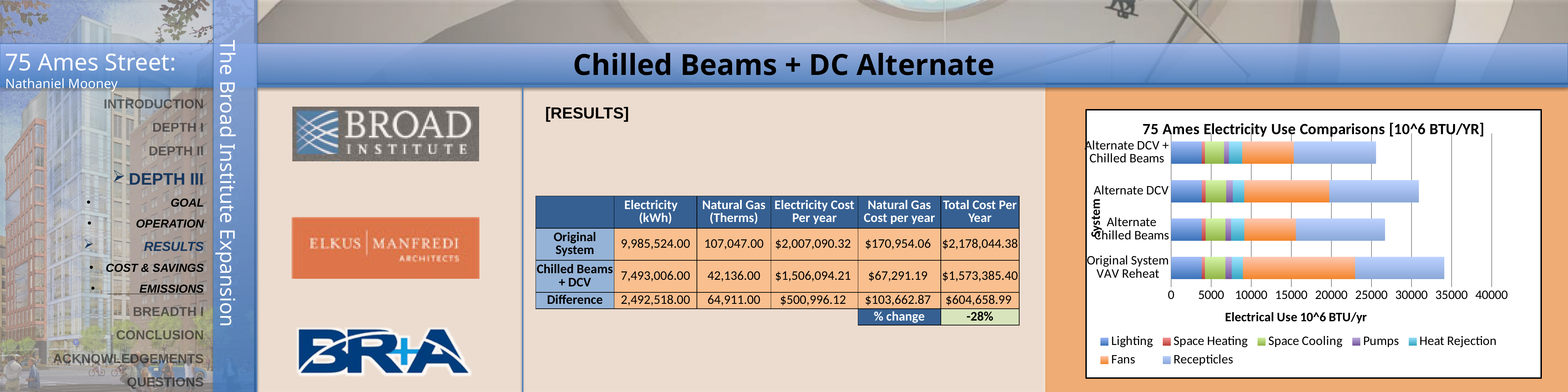
Is the total electrical use for Alternate DCV + Chilled Beams greater or less than 30000? less Is the total electrical use for Alternate Chilled Beams greater or less than 30000? less What is the label on the horizontal axis of the chart? Electrical Use 10^6 BTU/yr Is the total electrical use for Original System VAV Reheat greater or less than 30000? greater How many systems (categories) are plotted in the chart? 4 Which has the larger total electrical use: Alternate DCV or Alternate DCV + Chilled Beams? Alternate DCV What type of chart is shown on the slide? Bar chart What is the title of the chart? 75 Ames Electricity Use Comparisons [10^6 BTU/YR] Which system has the highest total electrical use in the chart? Original System VAV Reheat How many series does the chart legend list? 7 Which has the larger total electrical use: Original System VAV Reheat or Alternate Chilled Beams? Original System VAV Reheat